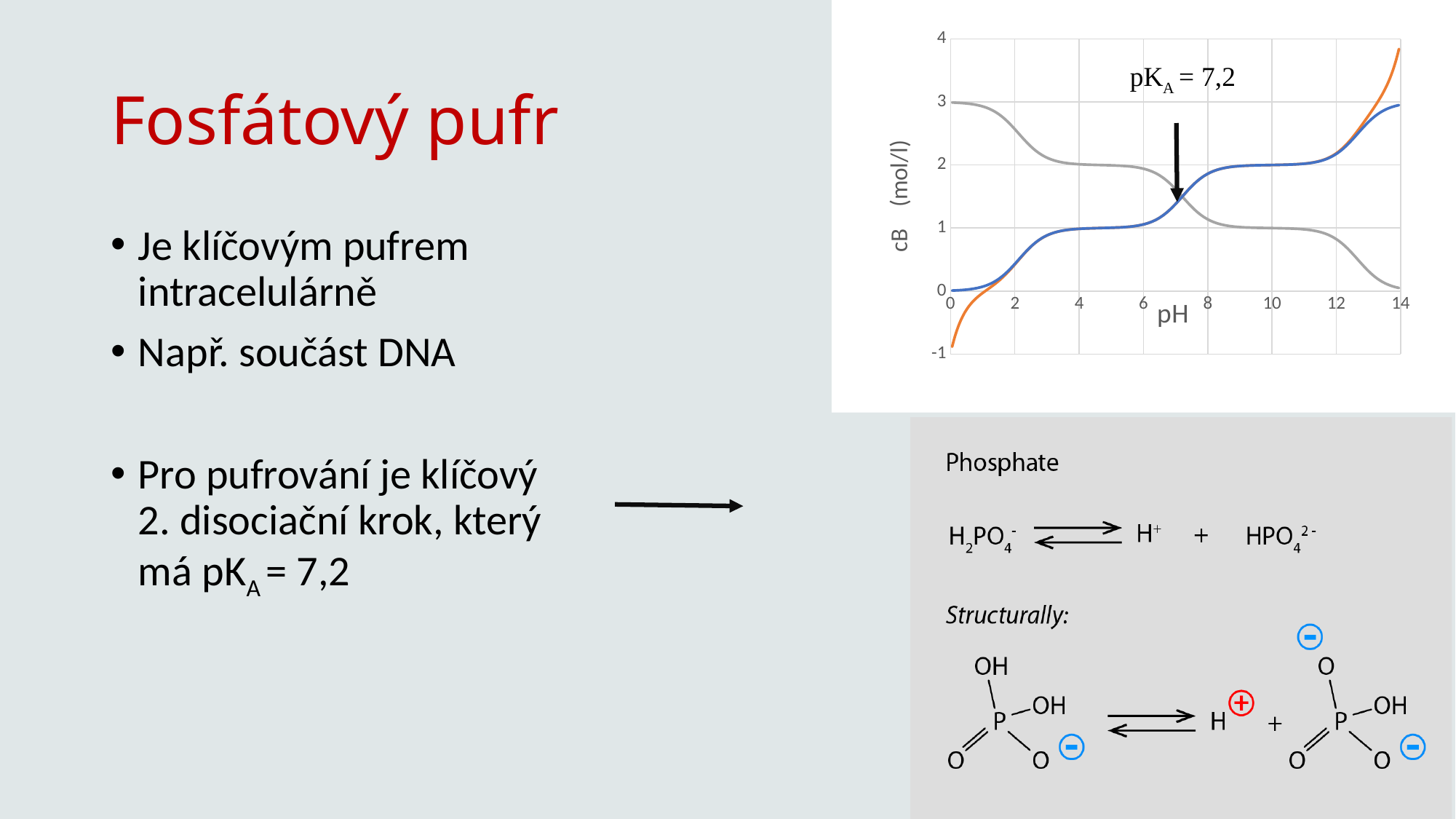
Does the blue curve rise or fall as pH increases? rise Does the grey curve rise or fall as pH increases? fall Is the value of the orange curve at pH 14 greater or less than 3? greater What pKA value is annotated with the arrow on the chart? pKA = 7,2 What kind of chart is shown on the slide? line chart How many curves are plotted on the chart? 3 Is the value of the orange curve at pH 0 greater or less than 0? less What is the label of the x axis of the chart? pH What is the label of the y axis of the chart? cB (mol/l) What is the highest pH value shown on the x axis? 14 At pH 0, which curve has the larger value, the grey curve or the blue curve? grey curve Is the value of the grey curve at pH 0 greater or less than 2? greater